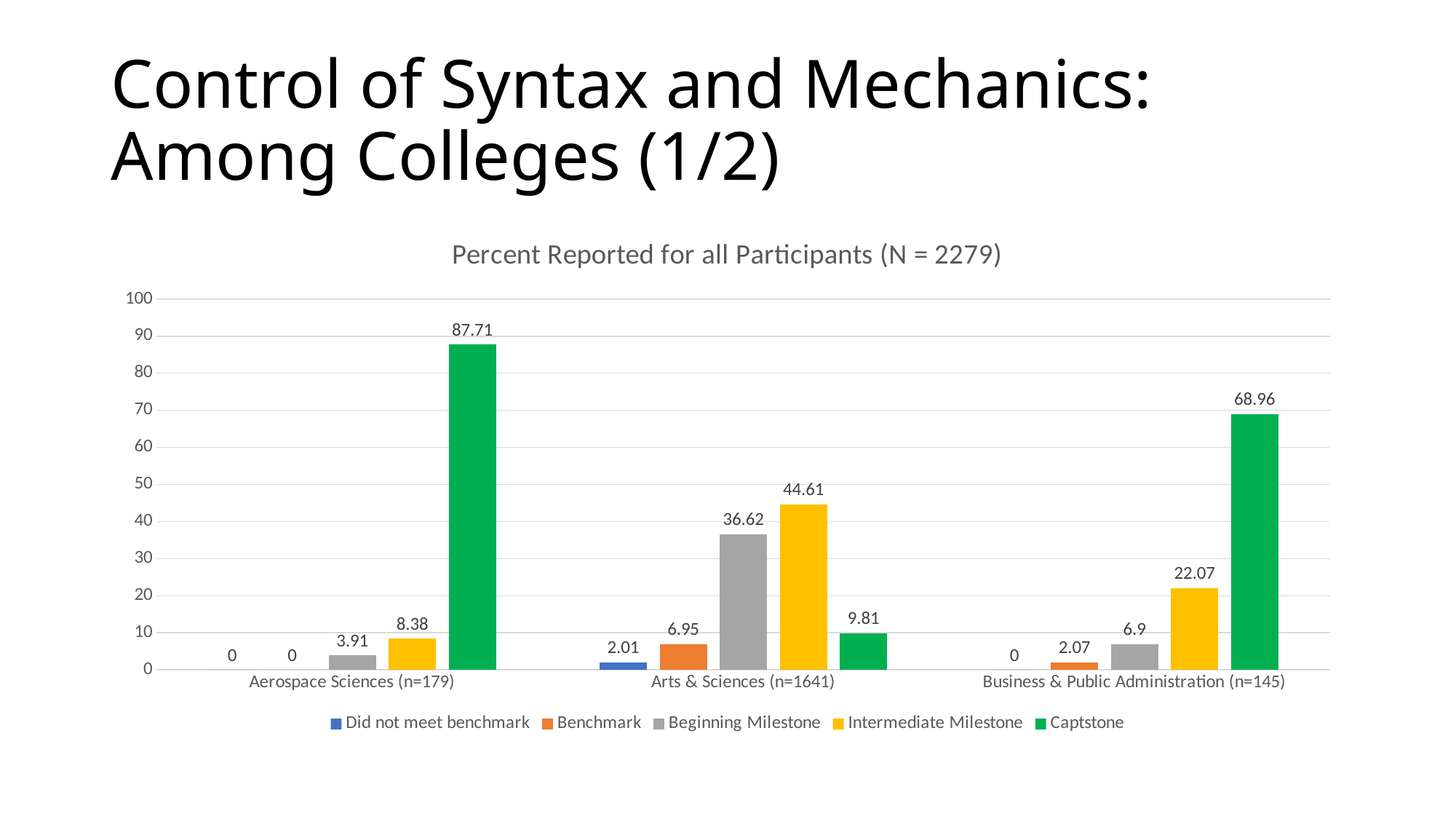
What is the Intermediate Milestone value for Arts & Sciences (n=1641)? 44.61 What is the Beginning Milestone value for Arts & Sciences (n=1641)? 36.62 What is the Benchmark value for Business & Public Administration (n=145)? 2.07 What kind of chart is shown on the slide? Bar chart How many colleges are shown on the x axis? 3 What is the Captstone value for Aerospace Sciences (n=179)? 87.71 Which is larger for Arts & Sciences (n=1641): the Beginning Milestone value or the Intermediate Milestone value? Intermediate Milestone Which college has the lowest Beginning Milestone value? Aerospace Sciences (n=179) How many series does the legend list? 5 What is the title of the chart? Percent Reported for all Participants (N = 2279) What is the difference between the Captstone values for Aerospace Sciences (n=179) and Business & Public Administration (n=145)? 18.75 Which college has the highest Captstone value? Aerospace Sciences (n=179)